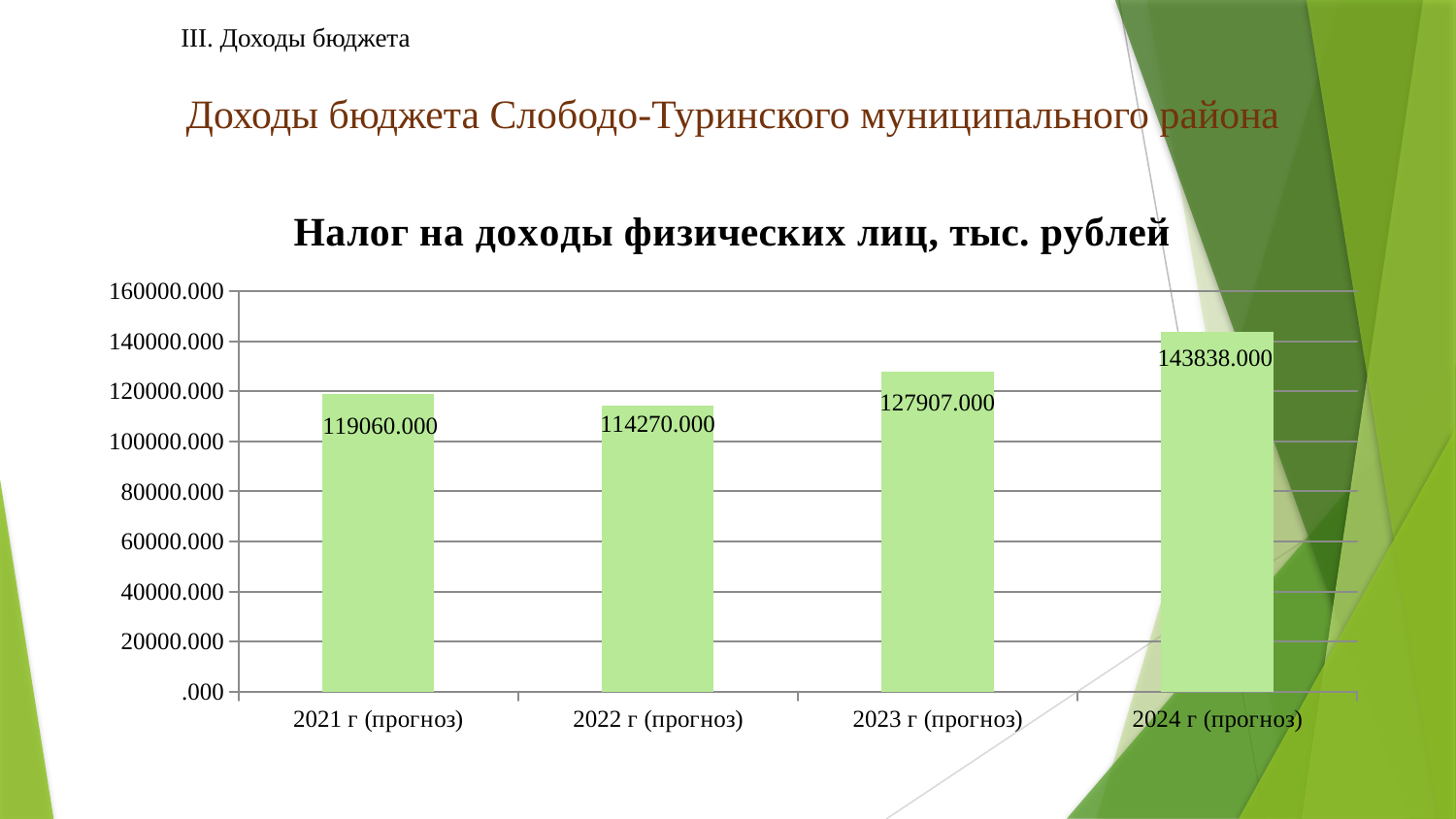
What is the value for 2021 г (прогноз)? 119060.000 What is the value for 2022 г (прогноз)? 114270.000 What kind of chart is shown on the slide? bar chart What is the value for 2024 г (прогноз)? 143838.000 Which is larger, the value for 2021 г (прогноз) or 2023 г (прогноз)? 2023 г (прогноз) Which category has the lowest value? 2022 г (прогноз) How many categories are shown on the x axis? 4 What is the difference between the values for 2021 г (прогноз) and 2022 г (прогноз)? 4790.000 What is the difference between the values for 2024 г (прогноз) and 2023 г (прогноз)? 15931.000 Which category has the highest value? 2024 г (прогноз) Is the value for 2022 г (прогноз) greater or less than 120000.000? less What is the value for 2023 г (прогноз)? 127907.000